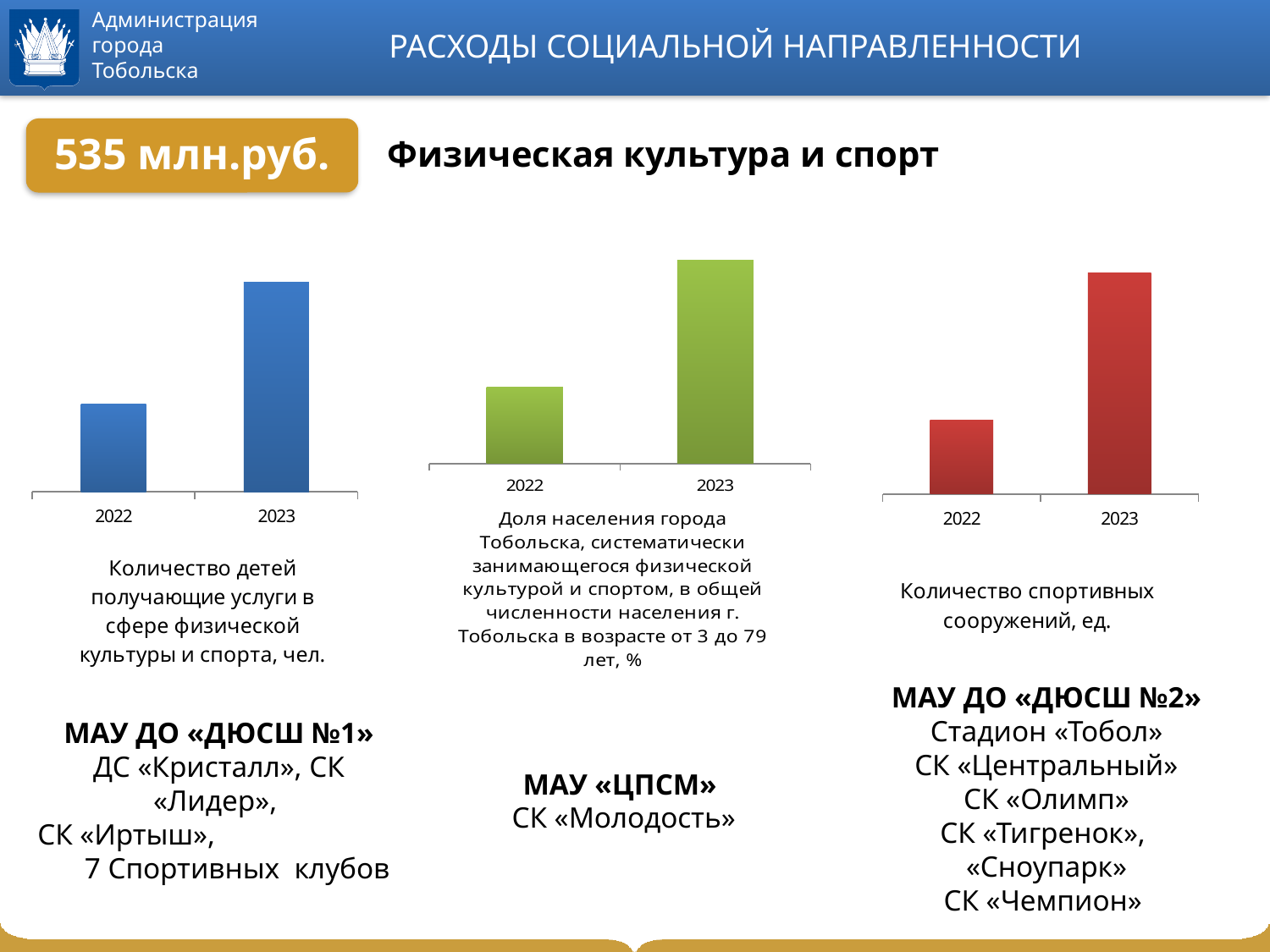
In the right chart (Количество спортивных сооружений, ед.), how many bars are plotted? 2 What kind of chart is the left chart (Количество детей получающие услуги в сфере физической культуры и спорта, чел.)? bar chart In the middle chart (Доля населения города Тобольска, систематически занимающегося физической культурой и спортом, %), which year has the lower value? 2022 In the left chart (Количество детей получающие услуги в сфере физической культуры и спорта, чел.), which year has the higher value? 2023 In the left chart (Количество детей получающие услуги в сфере физической культуры и спорта, чел.), how many years are shown on the x axis? 2 In the right chart (Количество спортивных сооружений, ед.), does the value rise or fall from 2022 to 2023? rise What kind of chart is the middle chart (Доля населения города Тобольска, систематически занимающегося физической культурой и спортом, %)? bar chart In the left chart (Количество детей получающие услуги в сфере физической культуры и спорта, чел.), does the value rise or fall from 2022 to 2023? rise What colour are the bars in the middle chart (Доля населения города Тобольска, систематически занимающегося физической культурой и спортом, %)? green In the middle chart (Доля населения города Тобольска, систематически занимающегося физической культурой и спортом, %), is the value for 2023 larger or smaller than the value for 2022? larger What colour are the bars in the right chart (Количество спортивных сооружений, ед.)? red In the right chart (Количество спортивных сооружений, ед.), which year has the higher value? 2023